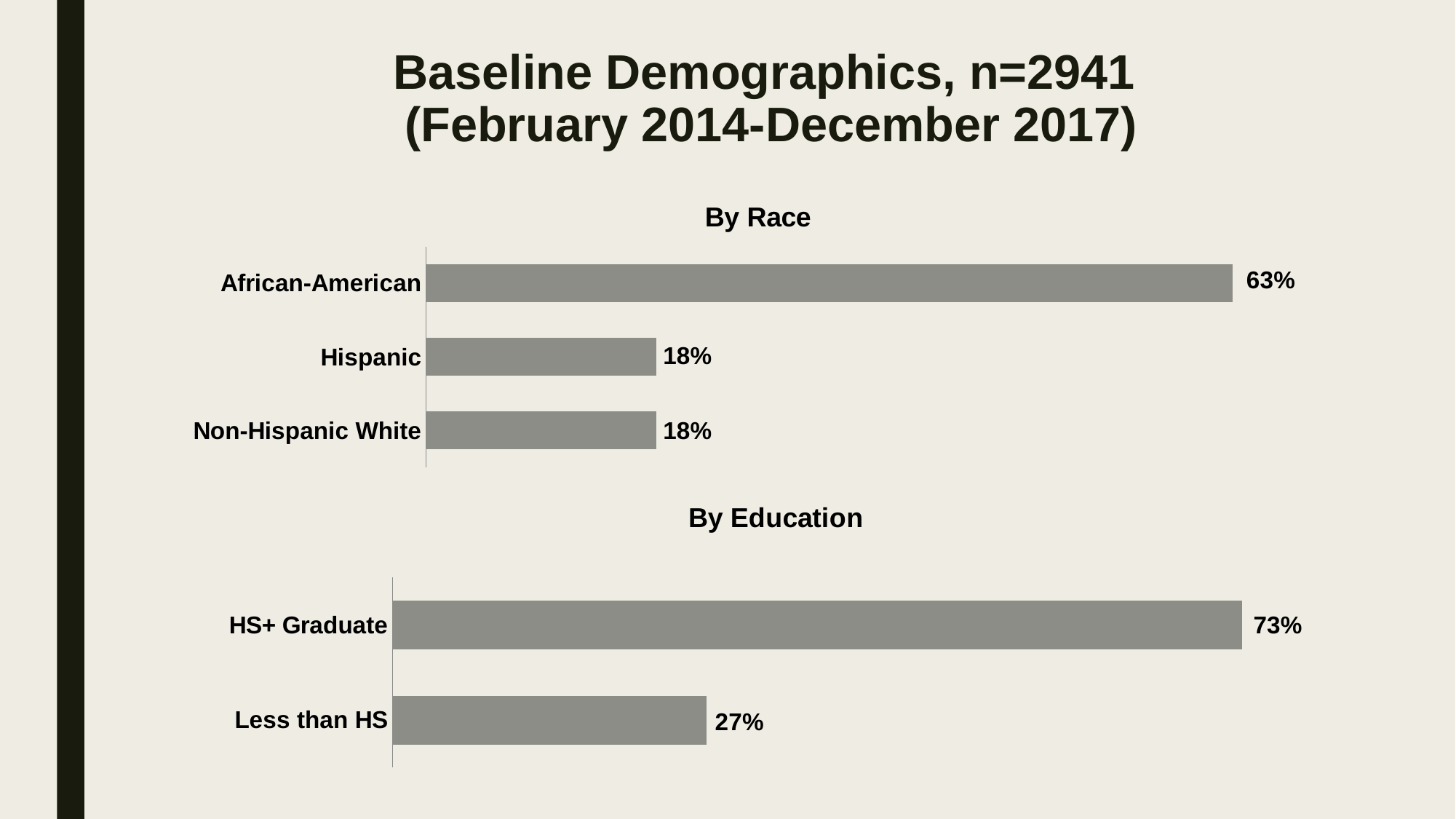
What type of chart is the 'By Education' chart? Bar chart In the 'By Race' chart, what percentage is shown for African-American? 63% In the 'By Education' chart, which category has the lowest percentage? Less than HS In the 'By Education' chart, what is the difference between HS+ Graduate and Less than HS? 46% How many categories are shown in the 'By Education' chart? 2 How many categories are shown in the 'By Race' chart? 3 In the 'By Race' chart, what percentage is shown for Hispanic? 18% In the 'By Education' chart, what percentage is shown for Less than HS? 27% In the 'By Race' chart, which category has the highest percentage? African-American In the 'By Race' chart, which is larger: the value for African-American or the value for Non-Hispanic White? African-American In the 'By Education' chart, what percentage is shown for HS+ Graduate? 73% In the 'By Race' chart, what is the difference between the African-American and Hispanic percentages? 45%